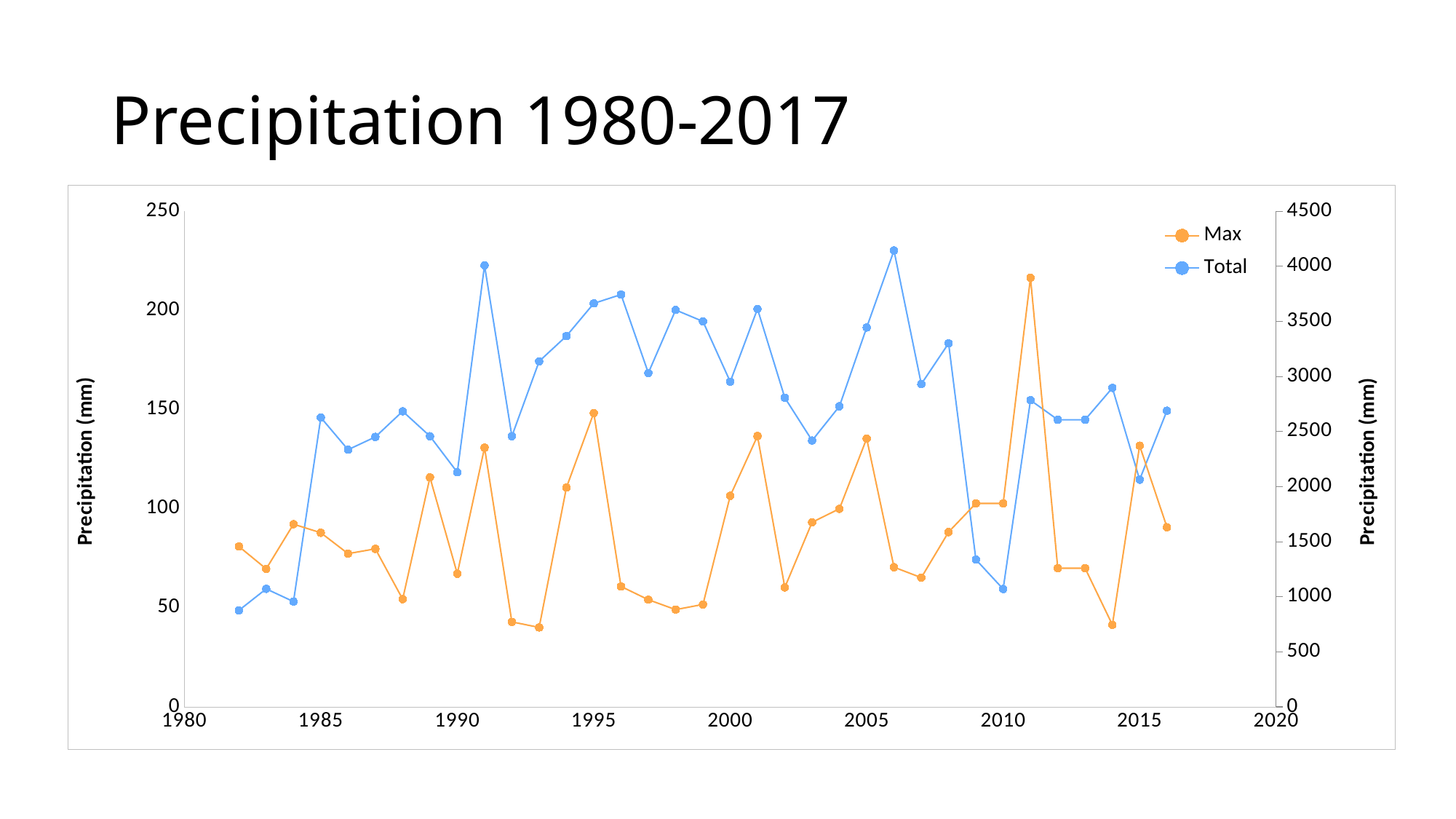
Is the Total value for 1982 greater or less than 1000? less How many series does the legend list? 2 Does the Max series rise or fall from 2011 to 2014? Fall In which year does the Max series reach its highest value? 2011 Is the Total value for 1991 greater or less than 3500? greater Is the Max value for 1993 greater or less than 50? less What are the two series named in the legend? Max and Total What kind of chart is shown on the slide? Line chart What is the title of the slide? Precipitation 1980-2017 Which is larger, the Total value for 2006 or the Total value for 2010? 2006